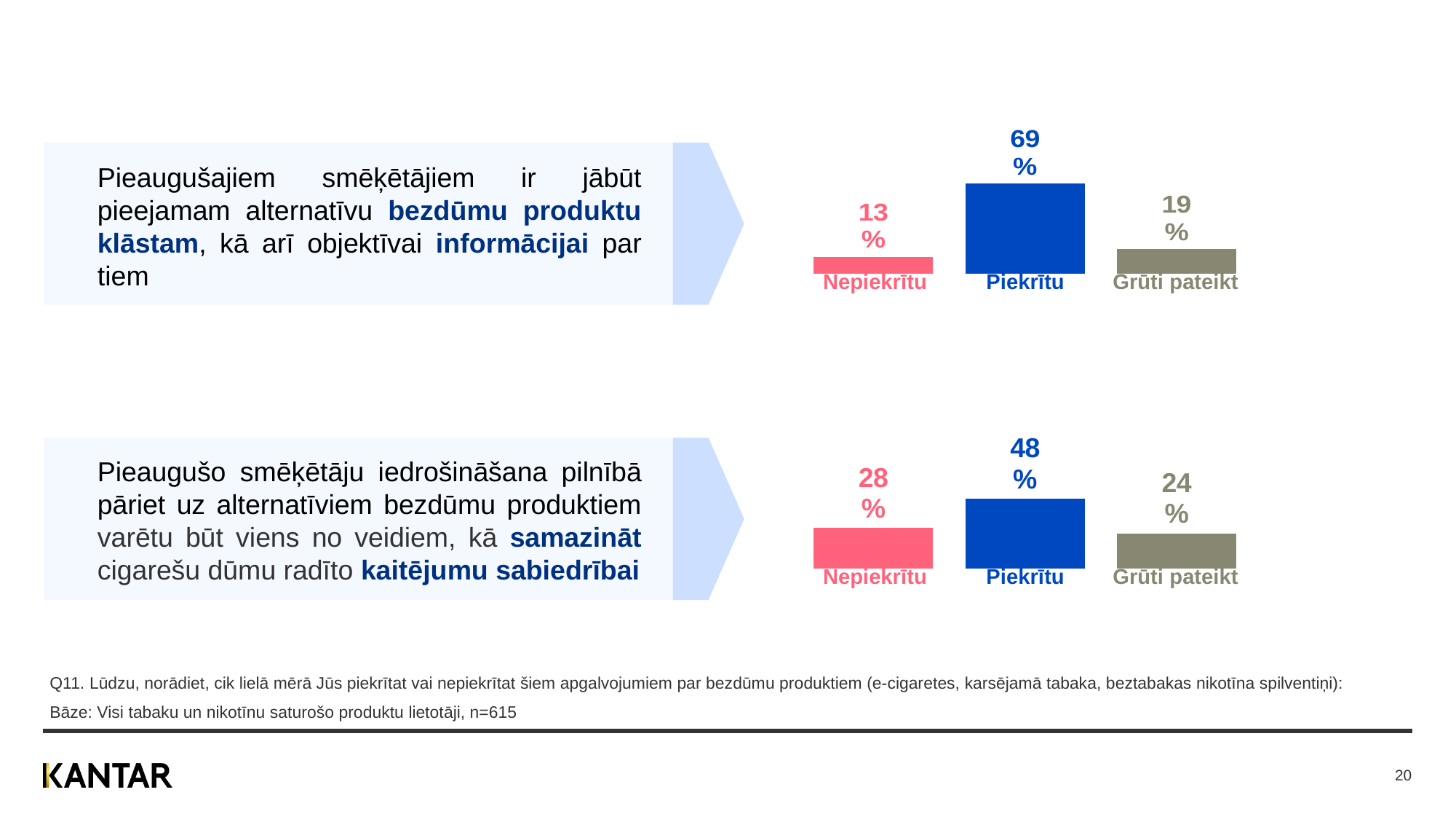
In the top chart, which category has the highest value? Piekrītu In the top chart, what is the difference between Grūti pateikt and Nepiekrītu? 6% How many categories does the top chart show? 3 In the top chart, which category has the lowest value? Nepiekrītu In the top chart, what is the value for Nepiekrītu? 13% In the bottom chart, what is the value for Piekrītu? 48% In the bottom chart, what is the value for Grūti pateikt? 24% In the bottom chart, which is larger, Nepiekrītu or Grūti pateikt? Nepiekrītu In the top chart, what is the value for Piekrītu? 69% In the bottom chart, what is the difference between Piekrītu and Nepiekrītu? 20% What kind of chart is the bottom chart? Bar chart In the bottom chart, which category has the lowest value? Grūti pateikt